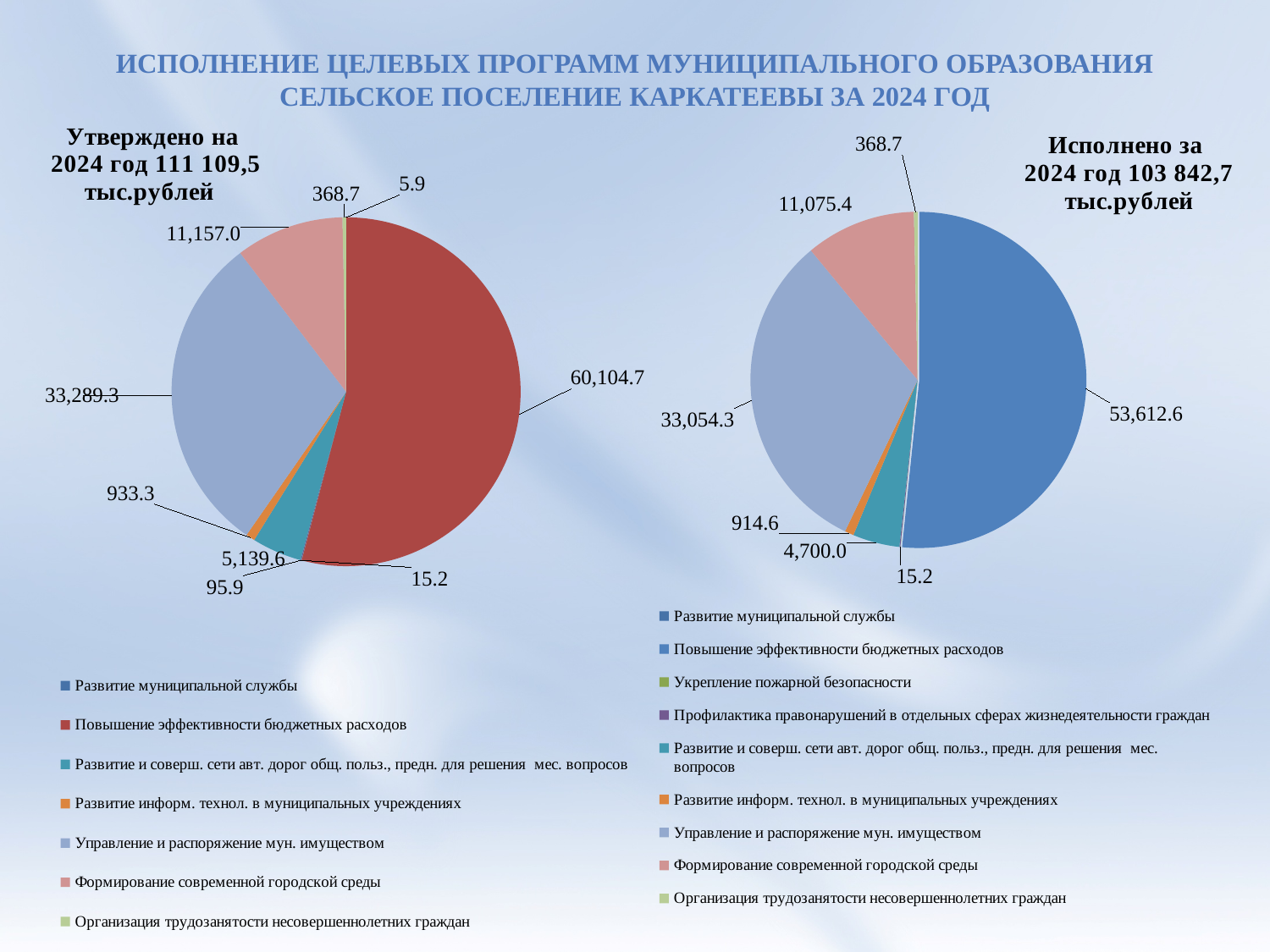
According to the heading of the left chart, what total amount was approved for 2024? 111 109,5 тыс.рублей In the left pie chart (Утверждено на 2024 год), what is the value of the largest slice? 60,104.7 In the left pie chart (Утверждено на 2024 год), what is the value for Развитие информ. технол. в муниципальных учреждениях? 933.3 What is the difference between the value for Развитие и соверш. сети авт. дорог in the left chart (5,139.6) and in the right chart (4,700.0)? 439.6 What is the difference between the value for Управление и распоряжение мун. имуществом in the left chart (33,289.3) and in the right chart (33,054.3)? 235.0 In the right pie chart (Исполнено за 2024 год), what is the value for Формирование современной городской среды? 11,075.4 In the left pie chart (Утверждено на 2024 год), which is larger: Управление и распоряжение мун. имуществом or Формирование современной городской среды? Управление и распоряжение мун. имуществом What kind of chart is used on the left side of the slide (Утверждено на 2024 год)? Pie chart In the left pie chart (Утверждено на 2024 год), what is the value for Управление и распоряжение мун. имуществом? 33,289.3 How many entries does the legend of the right pie chart (Исполнено за 2024 год) list? 9 In the right pie chart (Исполнено за 2024 год), what is the value of the largest slice? 53,612.6 In the right pie chart (Исполнено за 2024 год), what is the value for Развитие и соверш. сети авт. дорог общ. польз., предн. для решения мес. вопросов? 4,700.0